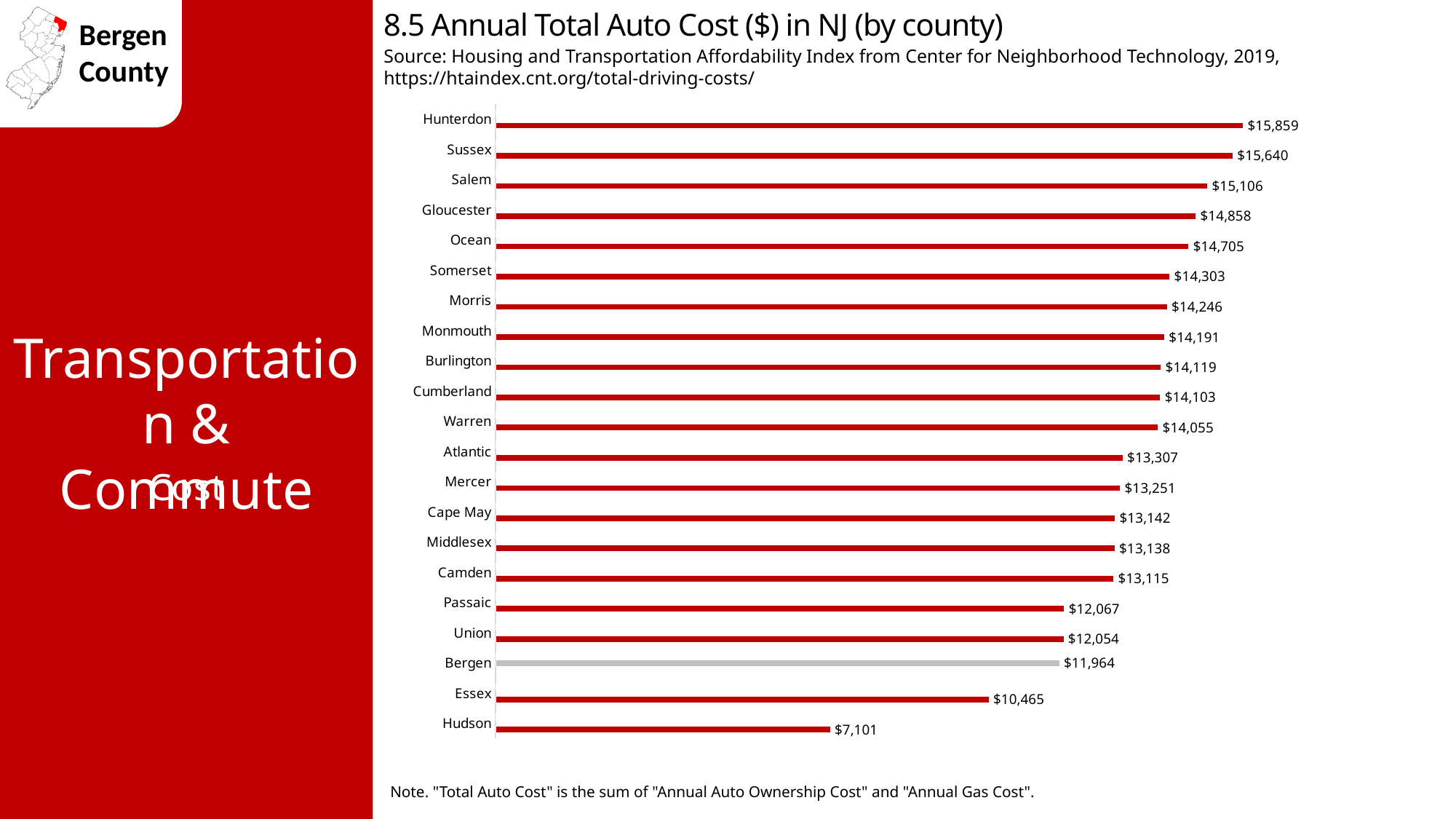
What is the difference in annual total auto cost between Hunterdon and Hudson? $8,758 How many counties are shown in the chart? 21 Which county has the highest annual total auto cost? Hunterdon Which county's bar is shown in gray instead of red? Bergen Which has a higher annual total auto cost, Passaic or Bergen? Passaic What is the annual total auto cost for Hudson County? $7,101 What is the difference in annual total auto cost between Bergen and Essex? $1,499 What is the annual total auto cost for Bergen County? $11,964 Which county has the lowest annual total auto cost? Hudson What is the annual total auto cost for Somerset County? $14,303 What type of chart is used to show annual total auto cost by county? Bar chart Which has a higher annual total auto cost, Sussex or Salem? Sussex